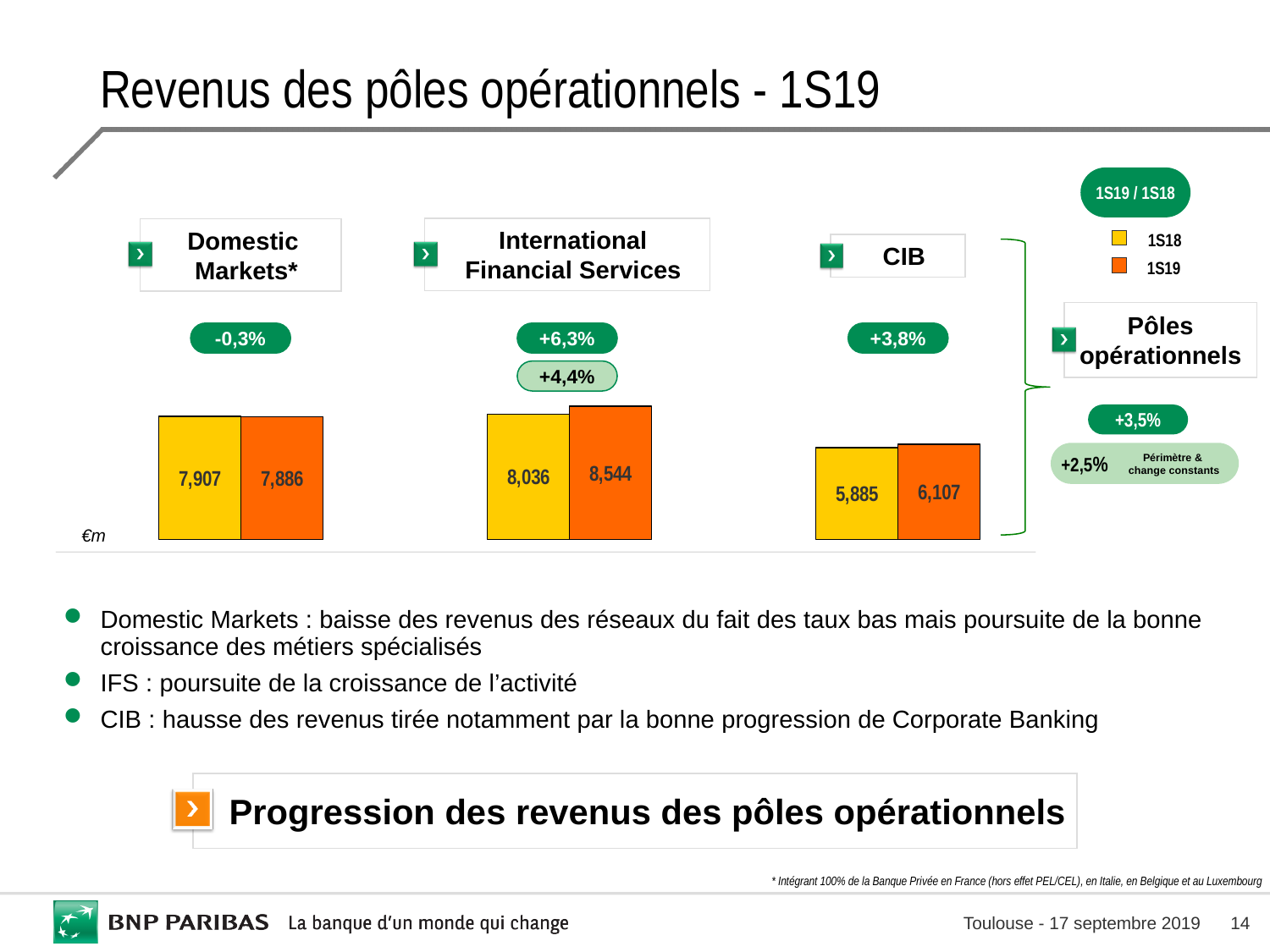
On the Domestic Markets chart, what is the revenue value for 1S19? 7,886 On the International Financial Services chart, which is larger, the 1S18 value or the 1S19 value? 1S19 What kind of chart is used to show the revenues of the operating divisions? Bar chart Across the three charts, which business line has the lowest 1S19 revenue? CIB On the CIB chart, what is the revenue value for 1S19? 6,107 On the CIB chart, what is the revenue value for 1S18? 5,885 On the International Financial Services chart, what is the difference between the 1S19 and 1S18 values? 508 Across the three charts, which business line has the highest 1S19 revenue? International Financial Services On the Domestic Markets chart, which is larger, the 1S18 value or the 1S19 value? 1S18 On the International Financial Services chart, what is the revenue value for 1S18? 8,036 How many series does the legend list for the charts? 2 On the CIB chart, what is the difference between the 1S19 and 1S18 values? 222